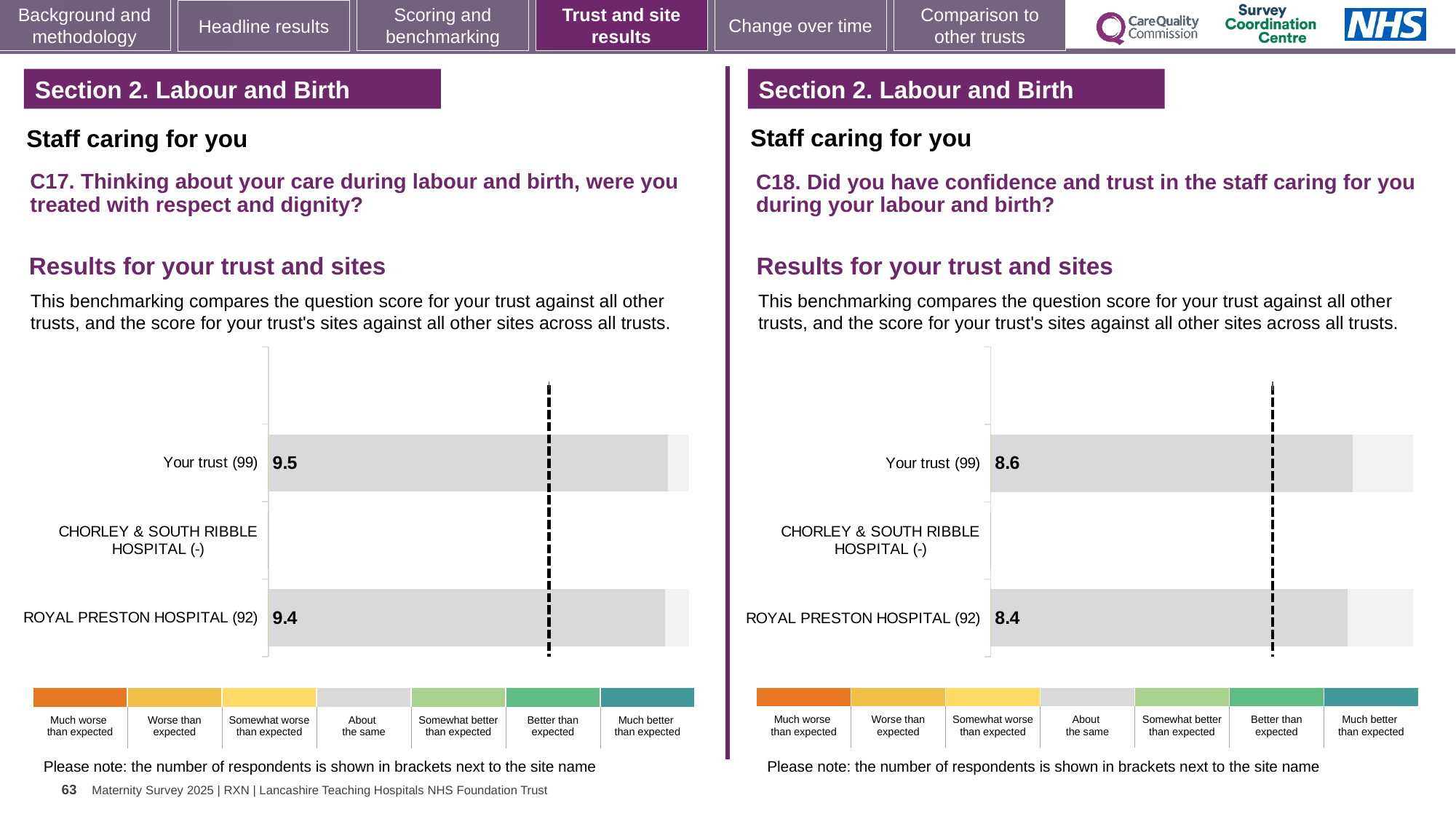
In the C18 chart on the right, how many respondents are shown in brackets for Your trust? 99 In the C17 chart on the left, how many respondents are shown in brackets for Royal Preston Hospital? 92 How many categories are listed on the vertical axis of the C17 chart on the left? 3 In the C18 chart on the right, which is higher: the score for Your trust or the score for Royal Preston Hospital? Your trust Is the score for Royal Preston Hospital in the C17 chart on the left greater or less than the score for Royal Preston Hospital in the C18 chart on the right? greater In the C17 chart on the left, what is the difference between the score for Your trust and the score for Royal Preston Hospital? 0.1 In the C17 chart on the left, what is the score for Royal Preston Hospital? 9.4 In the C17 chart on the left, what is the score for Your trust? 9.5 In the C18 chart on the right, what is the score for Royal Preston Hospital? 8.4 What kind of chart is used in the C18 chart on the right? Bar chart In the C18 chart on the right, what is the score for Your trust? 8.6 In the C18 chart on the right, what is the difference between the score for Your trust and the score for Royal Preston Hospital? 0.2